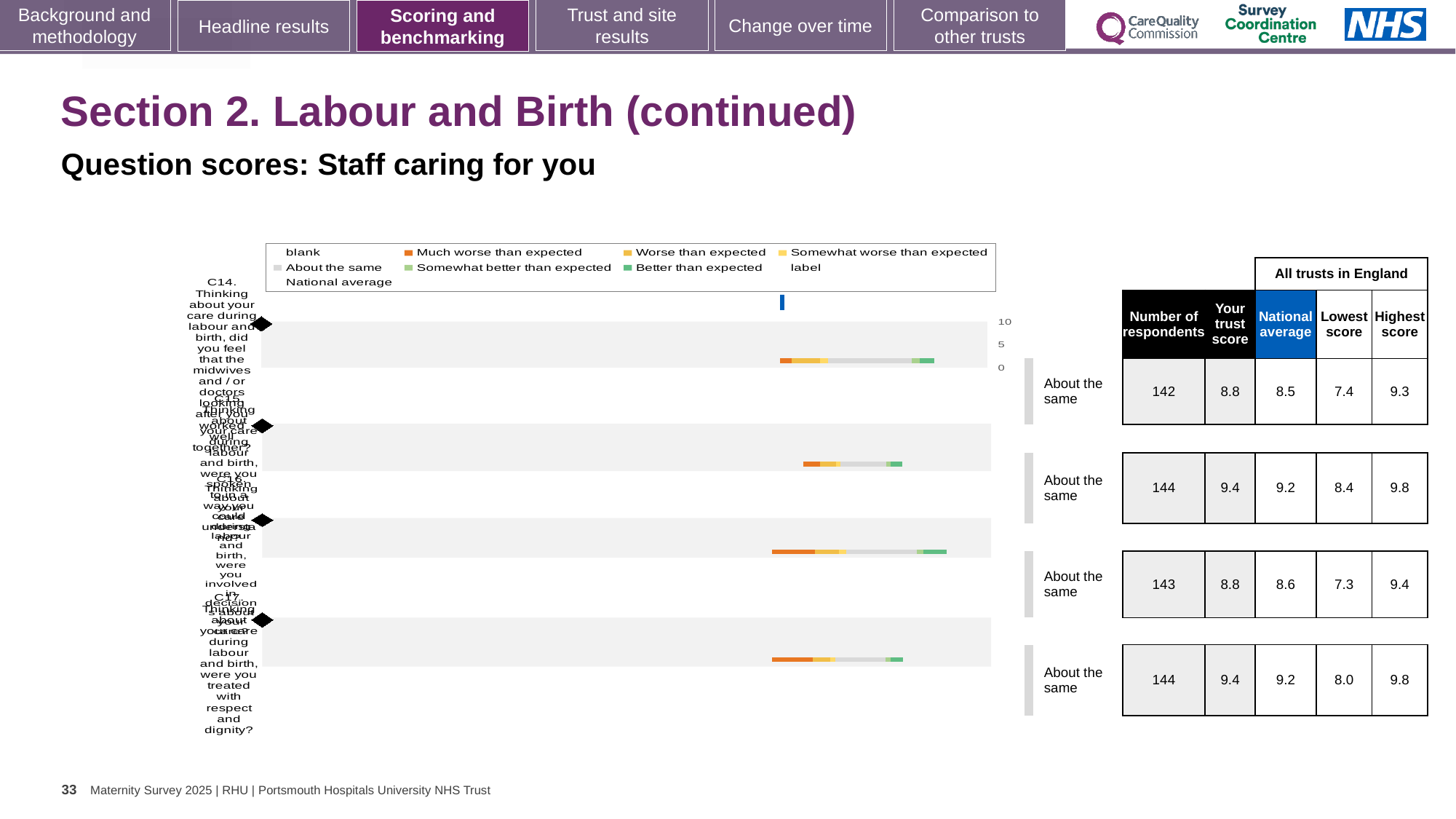
What kind of chart is shown on the slide? bar chart In the table beside the chart, what is the number of respondents for the first row (C14)? 142 What colour does the legend use for 'Much worse than expected'? orange In the table beside the chart, what is the 'Your trust score' for the second row (C15)? 9.4 What is the highest tick value shown on the chart's axis? 10 In the table beside the chart, is the trust score for the second row (C15) greater or less than the national average? greater In the table beside the chart, what is the national average for the third row (C16)? 8.6 How many entries does the chart legend list? 9 How many question rows are plotted in the chart? 4 In the table beside the chart, what is the lowest score for the fourth row (C17)? 8.0 In the table beside the chart, what is the difference between the trust score and the national average for the first row (C14)? 0.3 In the table beside the chart, which row has the lowest 'Lowest score' value? third row (C16), 7.3